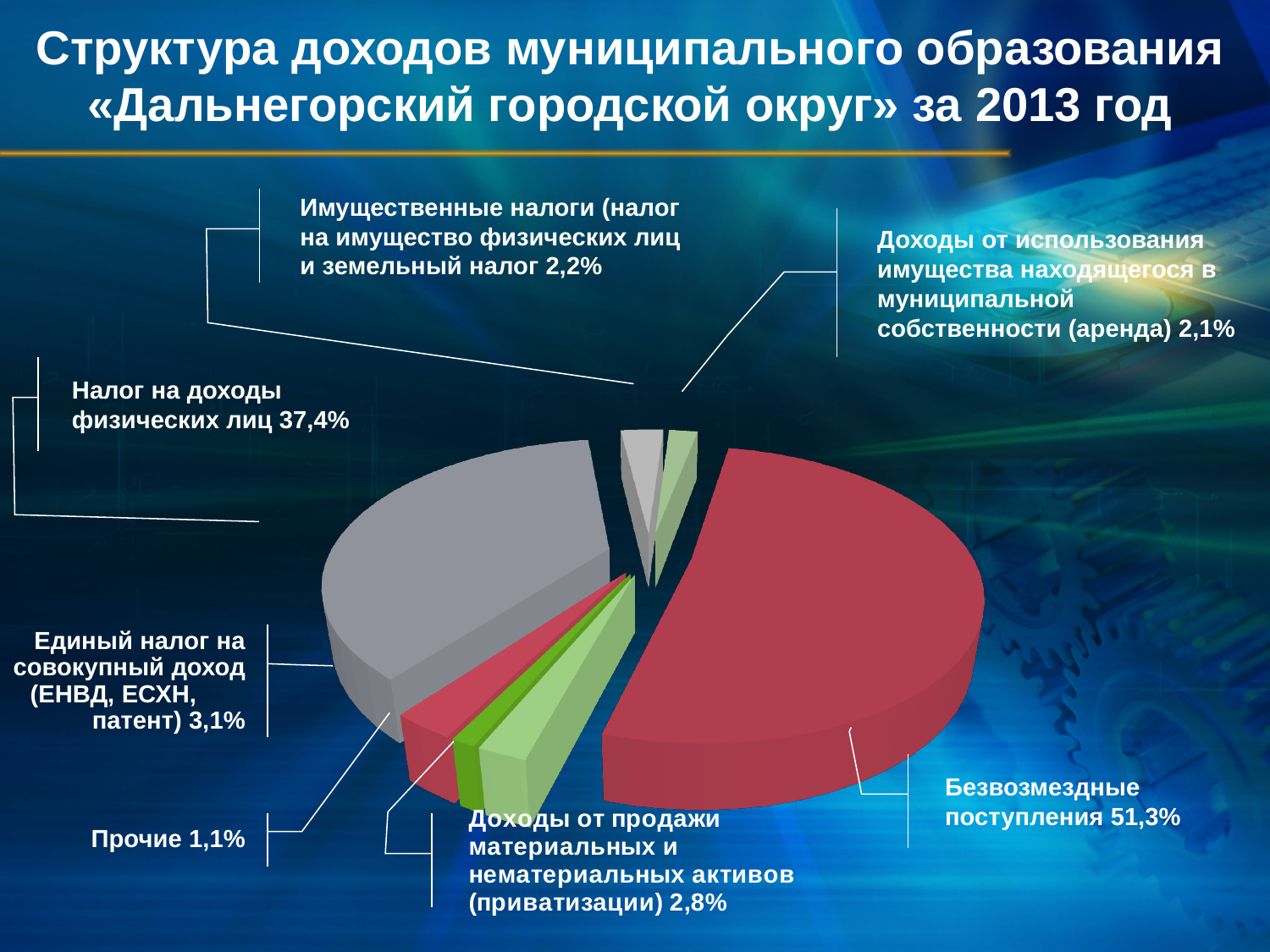
What is the difference between the shares of «Безвозмездные поступления» and «Налог на доходы физических лиц»? 13,9% Which revenue category has the smallest share? Прочие What share of revenue is «Налог на доходы физических лиц»? 37,4% Which is larger: «Имущественные налоги» or «Доходы от использования имущества (аренда)»? Имущественные налоги Which revenue category has the largest share? Безвозмездные поступления What share of revenue is «Безвозмездные поступления»? 51,3% What type of chart is shown on the slide? Pie chart What share is «Единый налог на совокупный доход (ЕНВД, ЕСХН, патент)»? 3,1% What share is «Доходы от использования имущества находящегося в муниципальной собственности (аренда)»? 2,1% How many slices does the pie chart have? 7 For which year does the chart show the revenue structure of «Дальнегорский городской округ»? 2013 What share is «Доходы от продажи материальных и нематериальных активов (приватизации)»? 2,8%